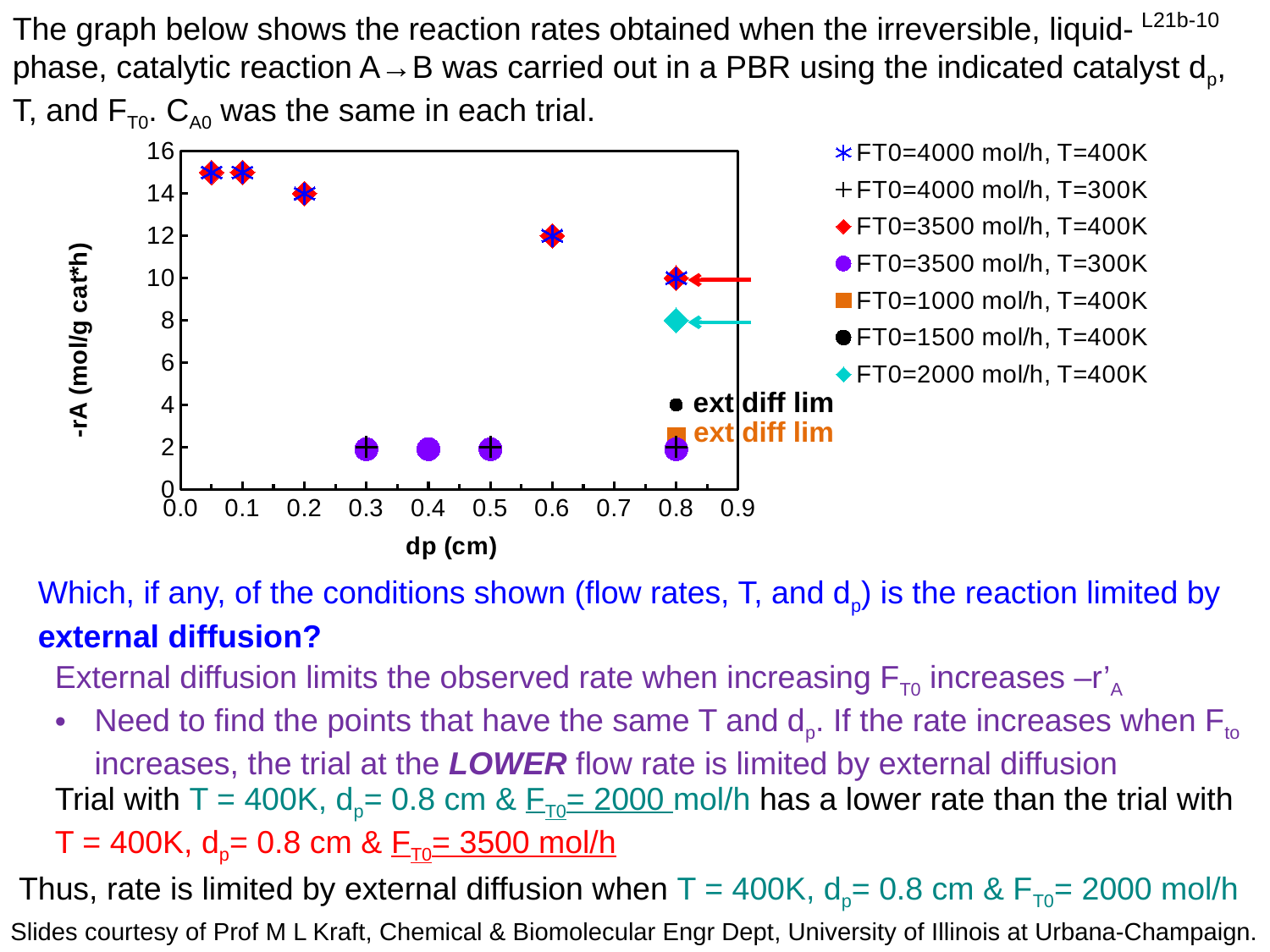
Is the value of -rA for the FT0=4000 mol/h, T=300K series at dp = 0.5 cm greater or less than 4? less At dp = 0.8 cm, what is the difference in -rA between the FT0=3500 mol/h, T=400K point and the FT0=2000 mol/h, T=400K point? 2 What kind of chart is shown on the slide? scatter chart What is the value of -rA for the FT0=2000 mol/h, T=400K series at dp = 0.8 cm? 8 For the T=400K series, does -rA rise or fall as dp increases along the x axis? fall Is the value of -rA for the FT0=4000 mol/h, T=400K series at dp = 0.05 cm greater or less than 14? greater At dp = 0.8 cm, which series has the larger -rA: FT0=3500 mol/h, T=400K or FT0=2000 mol/h, T=400K? FT0=3500 mol/h, T=400K How many series does the chart legend list? 7 What is the value of -rA for the FT0=3500 mol/h, T=400K series at dp = 0.8 cm? 10 What is the label of the x axis of the chart? dp (cm) What is the value of -rA for the FT0=4000 mol/h, T=400K series at dp = 0.6 cm? 12